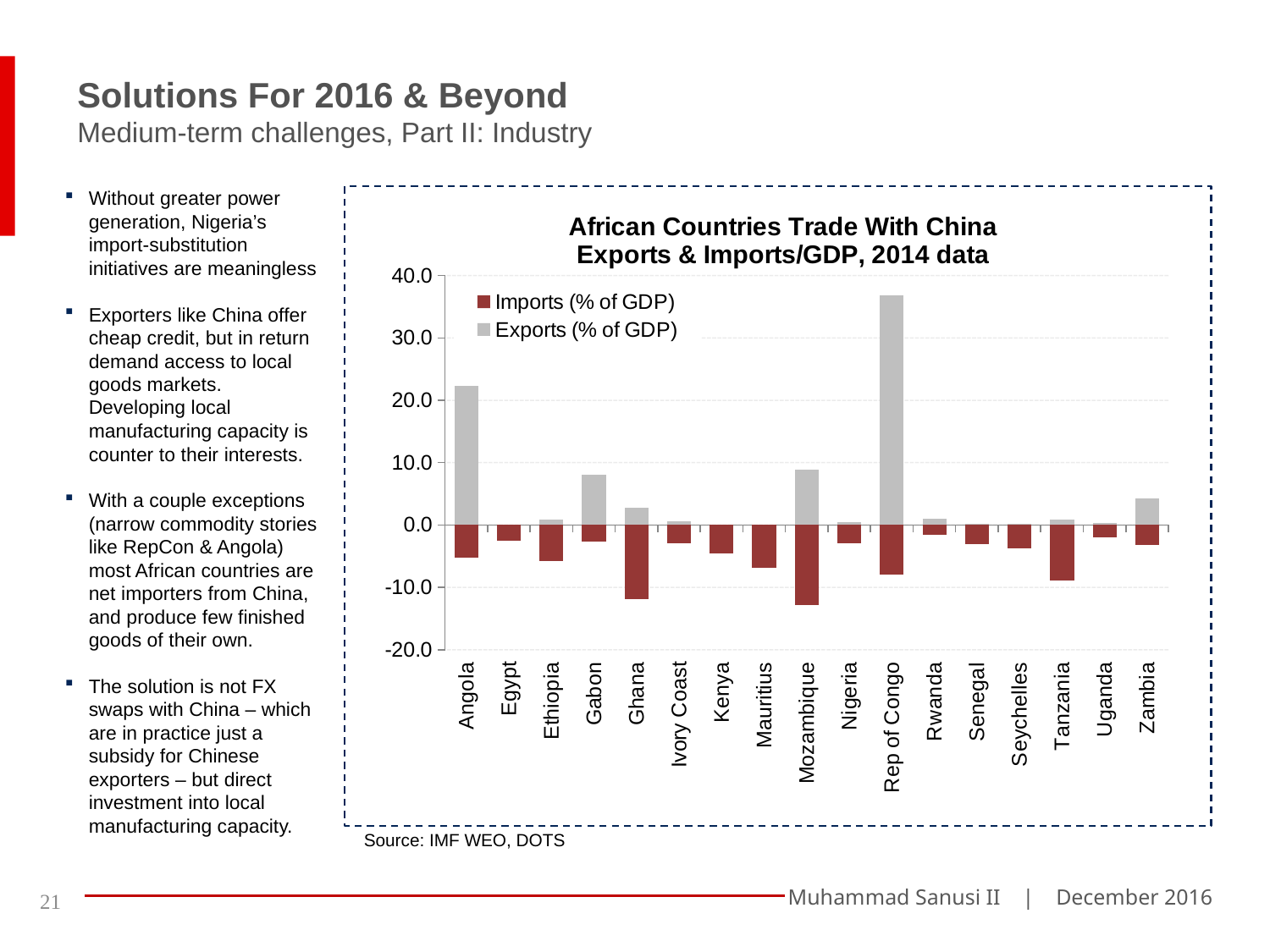
How many countries are shown on the x axis of the chart? 17 What colour are the Imports (% of GDP) bars in the chart? dark red Is the Exports (% of GDP) value for Rep of Congo greater or less than 30.0? greater How many series does the legend list? 2 Is the Imports (% of GDP) value for Mozambique greater or less than -10.0? less What type of chart is shown on the slide? bar chart Is the Exports (% of GDP) value for Angola greater or less than 20.0? greater What is the title of the chart? African Countries Trade With China Exports & Imports/GDP, 2014 data Which is larger, the Exports (% of GDP) value for Angola or for Gabon? Angola Which country has the highest Exports (% of GDP) value? Rep of Congo